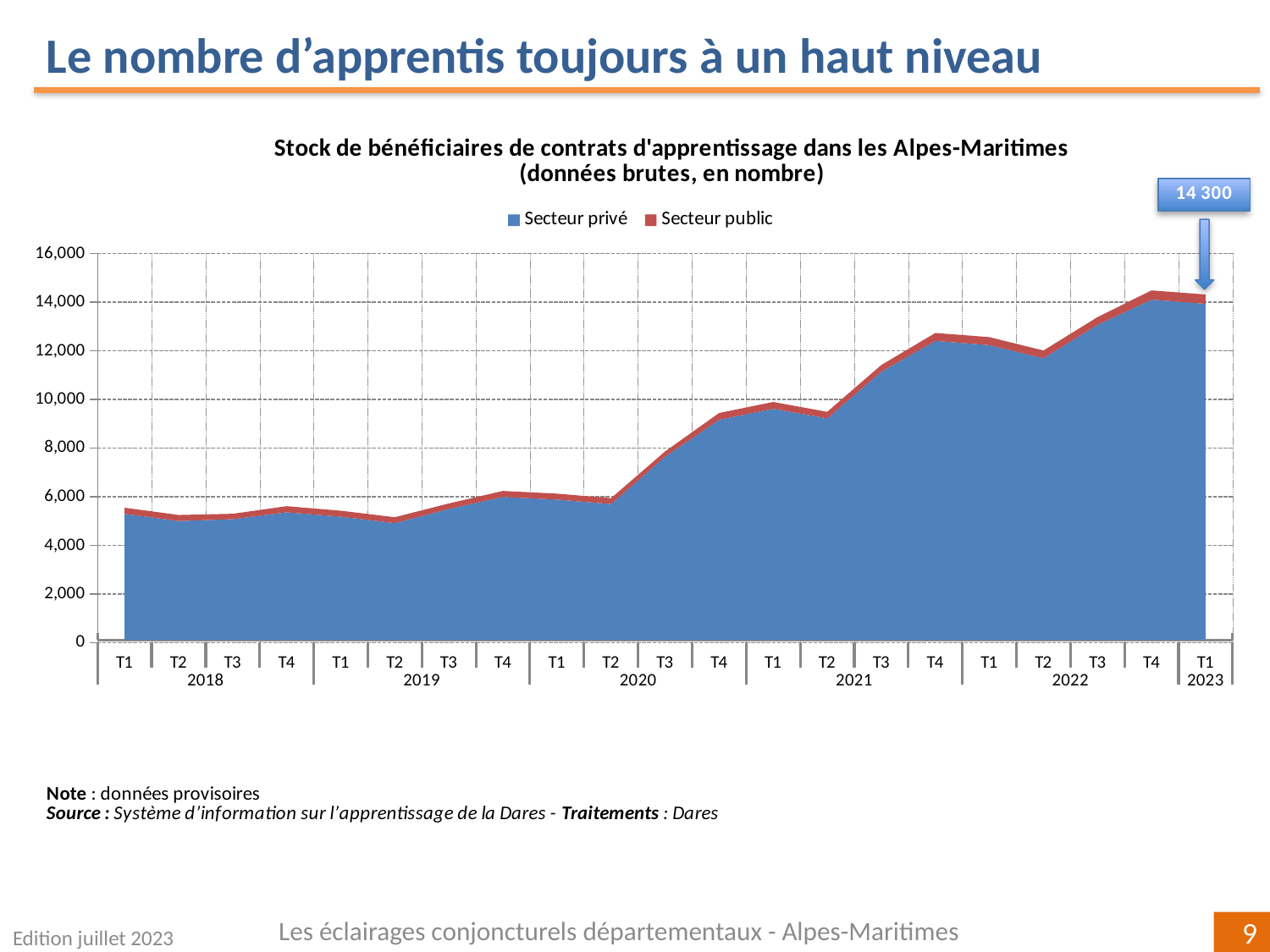
How many quarterly points are plotted on the x axis? 21 How many series does the legend list? 2 Is the total value for T1 2018 greater or less than 6,000? less Is the total value for T4 2021 greater or less than 12,000? greater Which is larger, the total for T4 2021 or the total for T2 2021? T4 2021 What kind of chart is shown on the slide? Area chart What value is annotated for T1 2023? 14 300 Is the total value for T3 2022 greater or less than 12,000? greater Does the total stock of apprentices rise or fall overall from T1 2018 to T1 2023? Rise Which sector accounts for the larger share of the stacked area? Secteur privé What are the two series named in the legend? Secteur privé and Secteur public